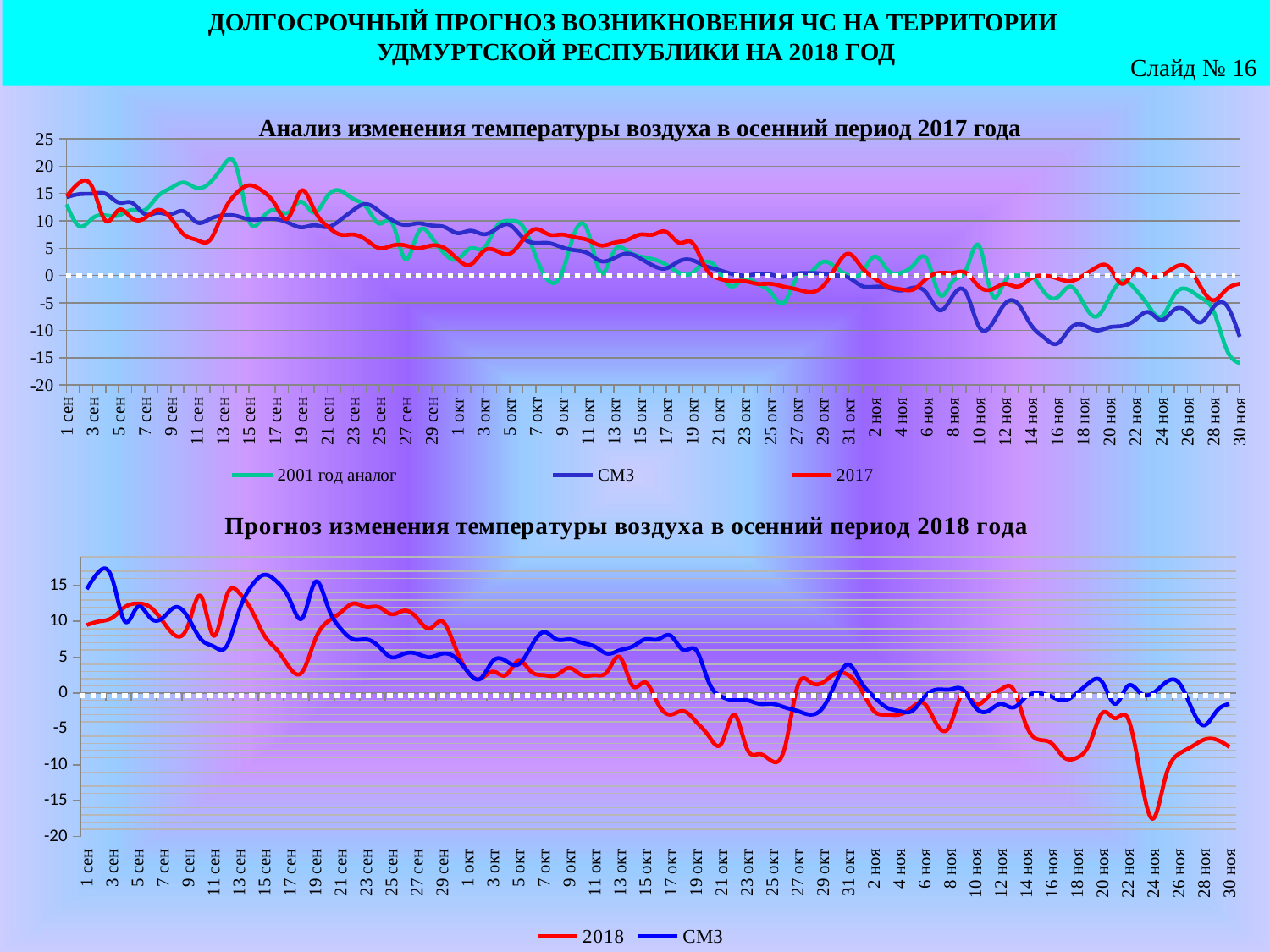
In the bottom chart (2018 forecast), which colour is used for the "2018" series? red In the top chart (2017 analysis), do the temperature values generally rise or fall from 1 сен to 30 ноя? fall In the top chart (2017 analysis), is the value of the "2017" series on 1 сен greater or less than 10? greater In the top chart (2017 analysis), is the value of the "2001 год аналог" series on 13 сен greater or less than 15? greater In the top chart (2017 analysis), is the value of the "СМЗ" series on 30 ноя greater or less than -5? less How many series does the legend of the top chart (2017 analysis) list? 3 What kind of chart is the top chart titled "Анализ изменения температуры воздуха в осенний период 2017 года"? line chart How many series does the legend of the bottom chart (2018 forecast) list? 2